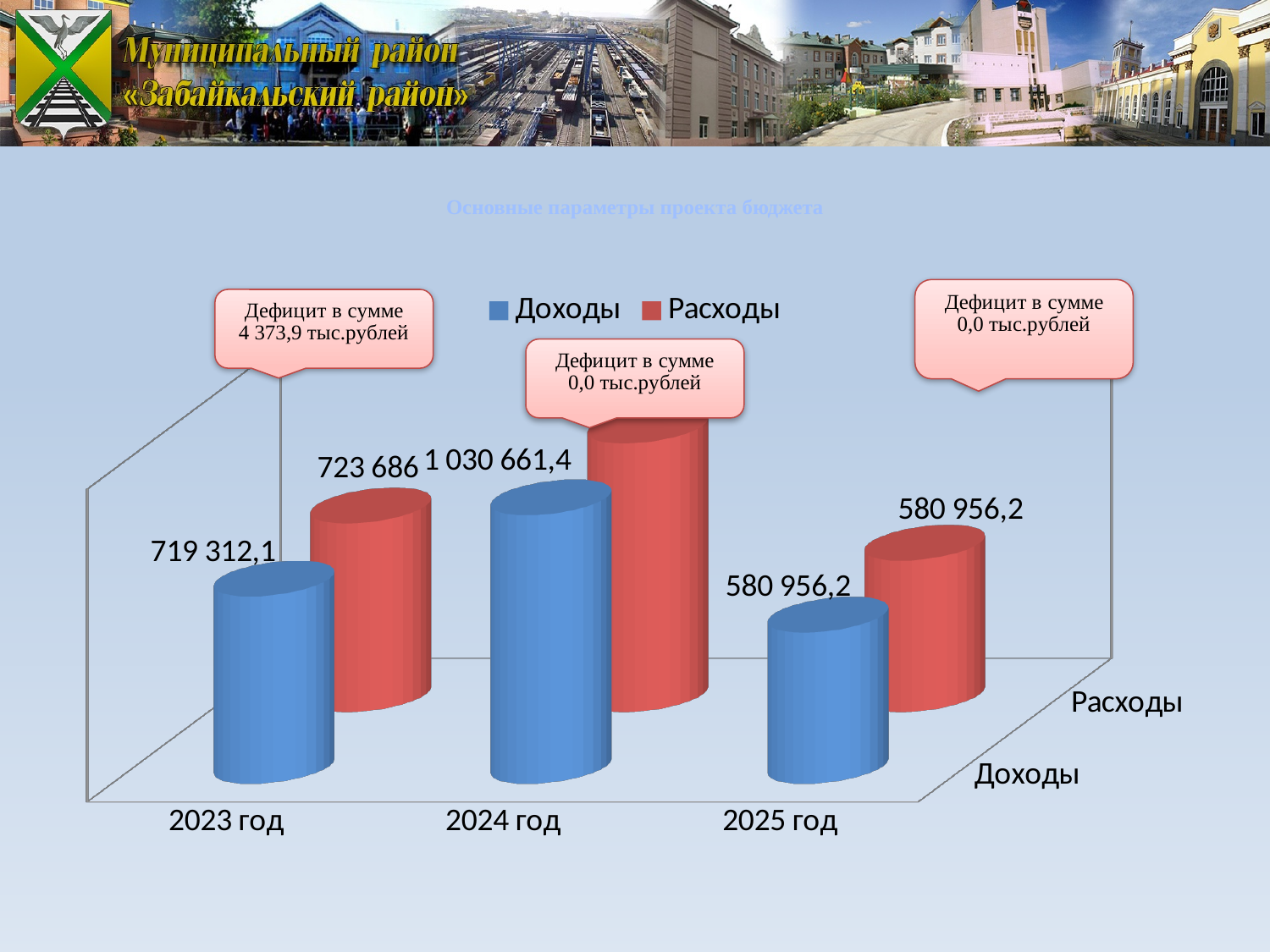
What is the value of Расходы for 2023 год? 723 686 What kind of chart is shown on the slide? Bar chart In which year is Доходы the lowest? 2025 год What is the value of Доходы for 2024 год? 1 030 661,4 How many years are shown on the x axis? 3 What is the value of Расходы for 2025 год? 580 956,2 What is the difference between Расходы and Доходы for 2023 год? 4 373,9 How many series does the legend list? 2 For 2024 год, which is larger: Доходы or Расходы? Neither; they are equal (1 030 661,4 each, deficit 0,0) In which year is Доходы the highest? 2024 год Which colour represents Расходы in the chart? Red What is the value of Доходы for 2023 год? 719 312,1